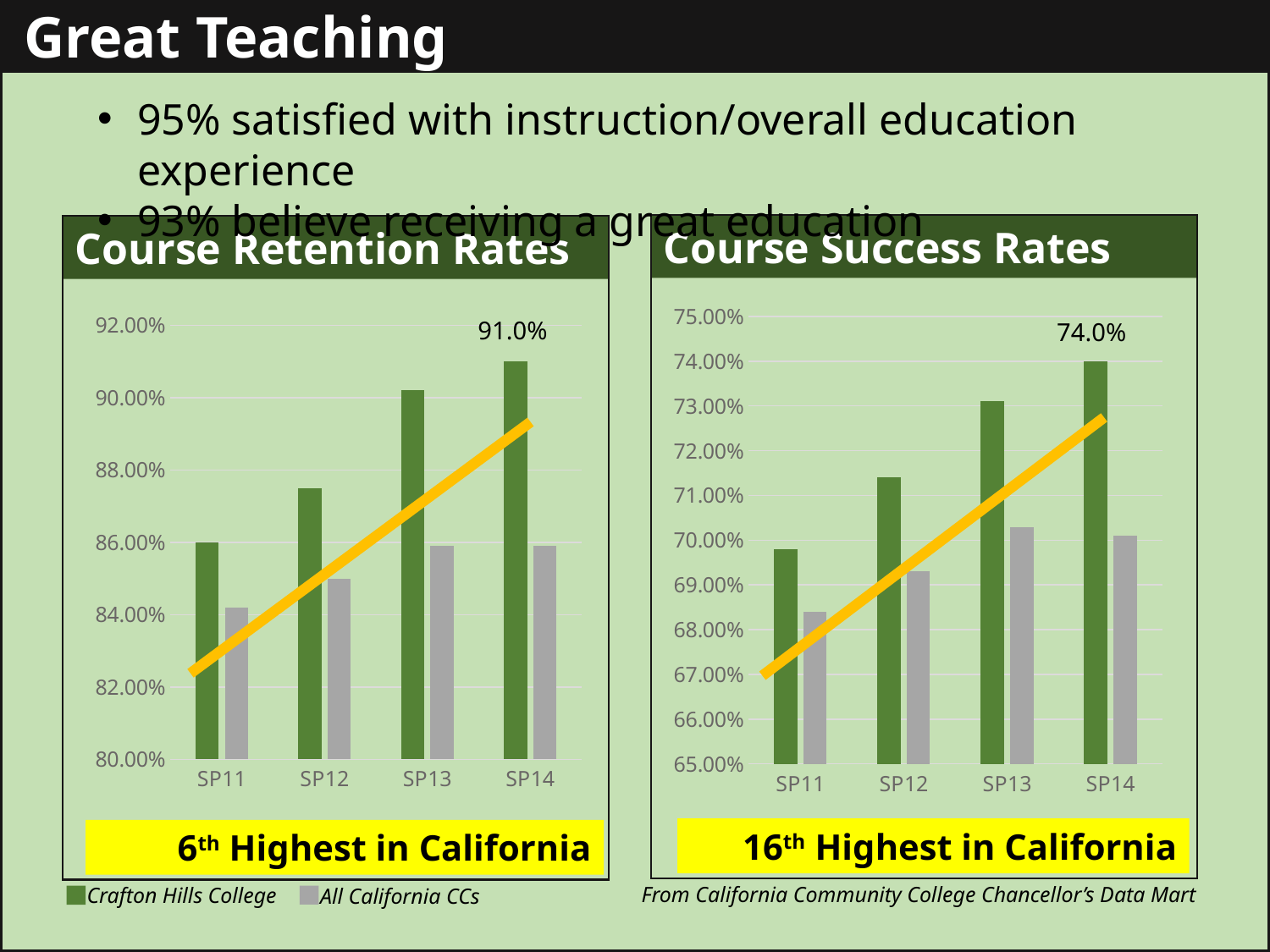
In the Course Retention Rates chart, which is larger in SP12: Crafton Hills College or All California CCs? Crafton Hills College In the Course Success Rates chart, which term has the lowest All California CCs bar? SP11 In the Course Success Rates chart, do the Crafton Hills College bars rise or fall from SP11 to SP14? rise How many terms are shown on the x axis of the Course Retention Rates chart? 4 In the Course Success Rates chart, what is the labelled value for Crafton Hills College in SP14? 74.0% In the Course Success Rates chart, is the Crafton Hills College value for SP12 greater or less than 71.00%? greater What kind of chart is the Course Success Rates chart? bar chart In the Course Retention Rates chart, is the All California CCs value for SP11 greater or less than 86.00%? less In the Course Retention Rates chart, what is the labelled value for Crafton Hills College in SP14? 91.0% Which series is shown in green in the charts? Crafton Hills College In the Course Retention Rates chart, which term has the highest Crafton Hills College bar? SP14 How many series does the legend list for the charts? 2